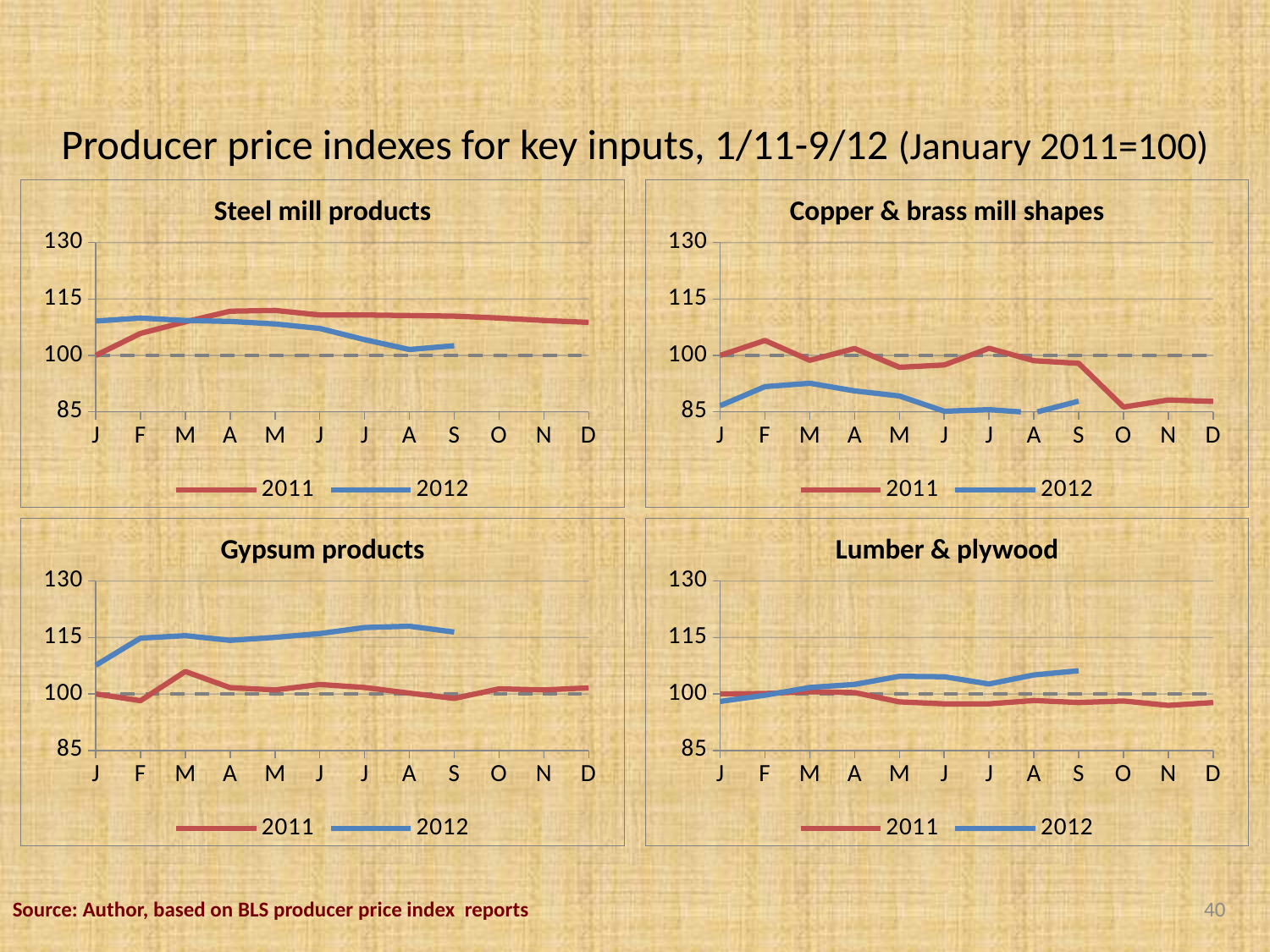
How many months are labeled on the x axis of the Lumber & plywood chart? 12 In the Copper & brass mill shapes chart, is the 2012 value for June greater or less than 100? less In the Steel mill products chart, is the 2012 value for August greater or less than 115? less In the Copper & brass mill shapes chart, which series is higher in March, 2011 or 2012? 2011 In the Gypsum products chart, is the 2012 value for January (J) greater or less than 100? greater How many series does the legend list in the Gypsum products chart? 2 In the Copper & brass mill shapes chart, does the 2011 line generally rise or fall from January to December? fall What kind of chart is the Steel mill products chart? line chart In the Gypsum products chart, which series is higher in May, 2011 or 2012? 2012 What is the title of the top-right chart? Copper & brass mill shapes In the Gypsum products chart, does the 2012 line rise or fall from January to February? rise